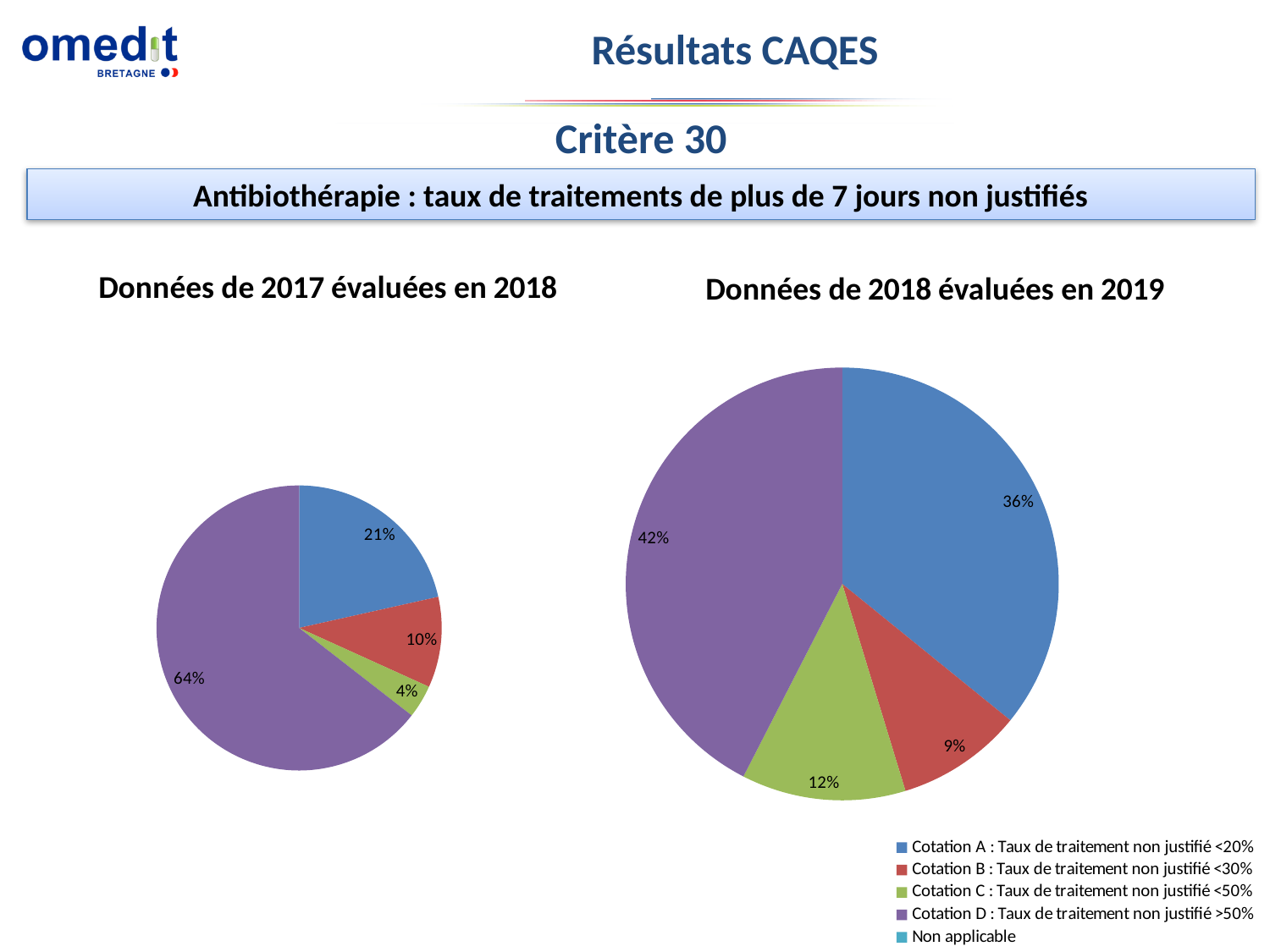
In the chart titled 'Données de 2018 évaluées en 2019', what share does Cotation A (Taux de traitement non justifié <20%) have? 36% How many entries does the legend on the slide list? 5 In the chart titled 'Données de 2017 évaluées en 2018', which cotation has the smallest slice? Cotation C In the chart titled 'Données de 2017 évaluées en 2018', what share does Cotation D (Taux de traitement non justifié >50%) have? 64% What kind of chart is used on this slide? Pie chart In the chart titled 'Données de 2017 évaluées en 2018', what is the value of the Cotation C slice? 4% In the chart titled 'Données de 2018 évaluées en 2019', which cotation has the smallest slice? Cotation B In the chart titled 'Données de 2018 évaluées en 2019', which is larger: the Cotation C slice or the Cotation B slice? Cotation C In the chart titled 'Données de 2017 évaluées en 2018', what is the difference between the Cotation A share and the Cotation B share? 11% In the chart titled 'Données de 2018 évaluées en 2019', what is the value of the Cotation B slice? 9% In the chart titled 'Données de 2018 évaluées en 2019', what is the difference between the Cotation D share and the Cotation A share? 6% In the chart titled 'Données de 2017 évaluées en 2018', which cotation has the largest slice? Cotation D